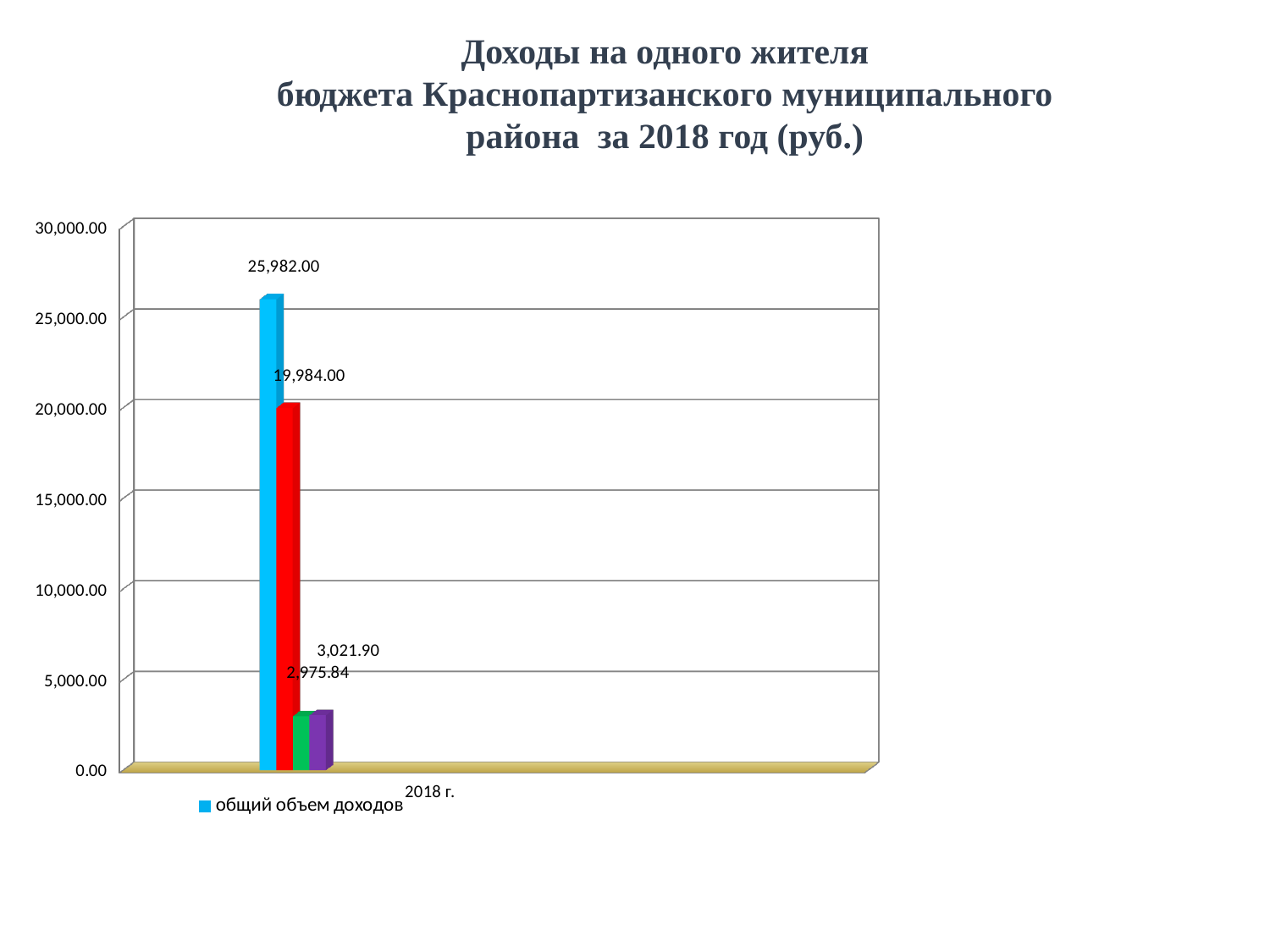
Which bar has the highest value? общий объем доходов (blue bar), 25,982.00 How many categories are shown on the x axis? 1 What is the value of the "общий объем доходов" bar? 25,982.00 What value is labelled on the purple bar? 3,021.90 What value is labelled on the green bar? 2,975.84 How many series does the legend list? 1 What kind of chart is shown on the slide? Bar chart What is the lowest value labelled on the chart? 2,975.84 What value is labelled on the red bar? 19,984.00 What is the difference between the blue bar (25,982.00) and the red bar (19,984.00)? 5,998.00 Is the value of the red bar greater or less than 15,000.00? greater Which is larger, the blue bar or the red bar? The blue bar